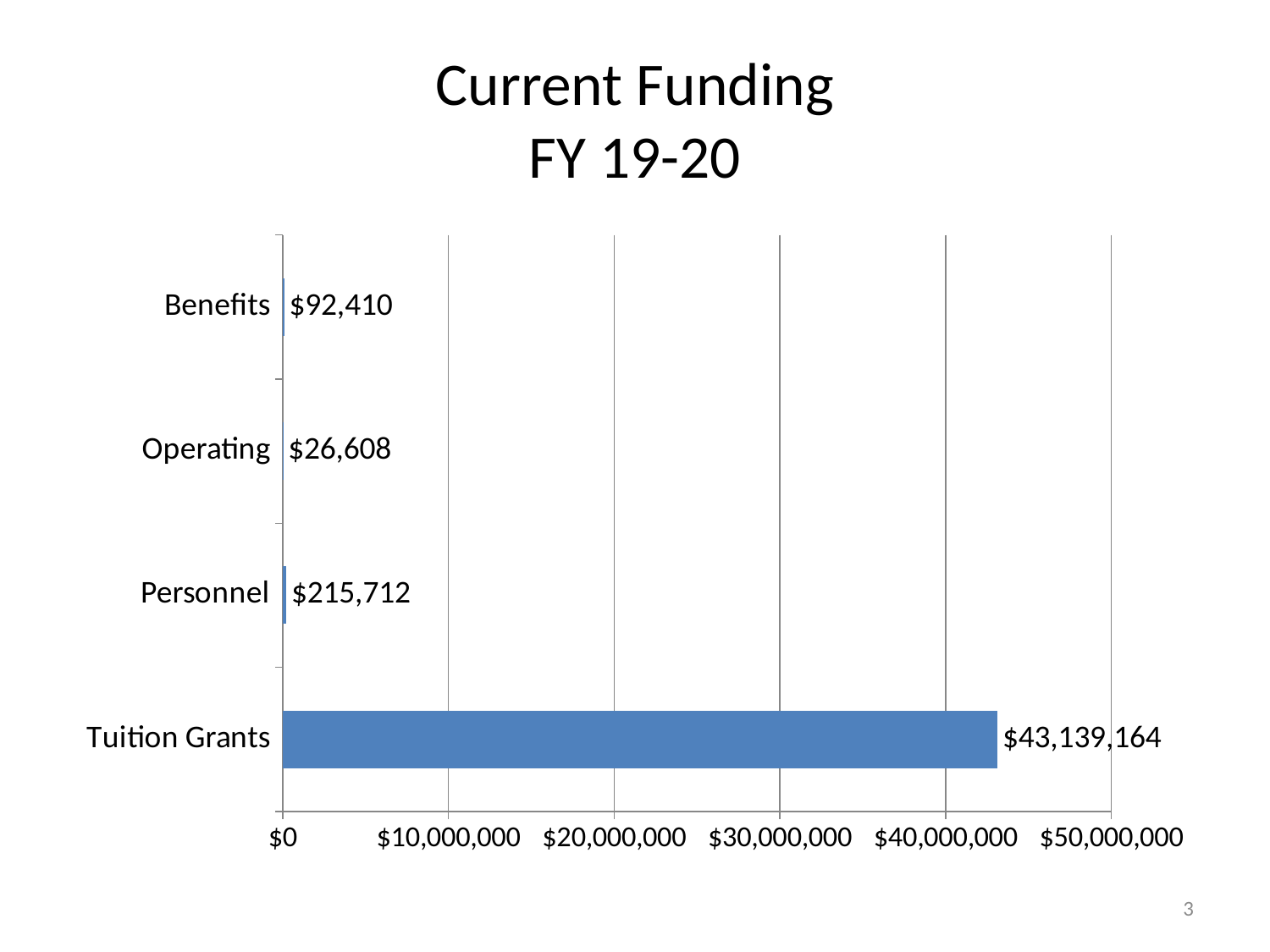
What is the value for Benefits? $92,410 Which category has the lowest value? Operating What is the value for Personnel? $215,712 Is the value for Tuition Grants greater or less than $40,000,000? greater How many categories are shown in the chart? 4 Which category has the highest value? Tuition Grants What is the difference between the Benefits and Operating values? $65,802 What is the value for Tuition Grants? $43,139,164 Which is larger, the value for Personnel or the value for Benefits? Personnel What kind of chart is shown on the slide? Bar chart What is the difference between the Personnel and Benefits values? $123,302 What is the value for Operating? $26,608